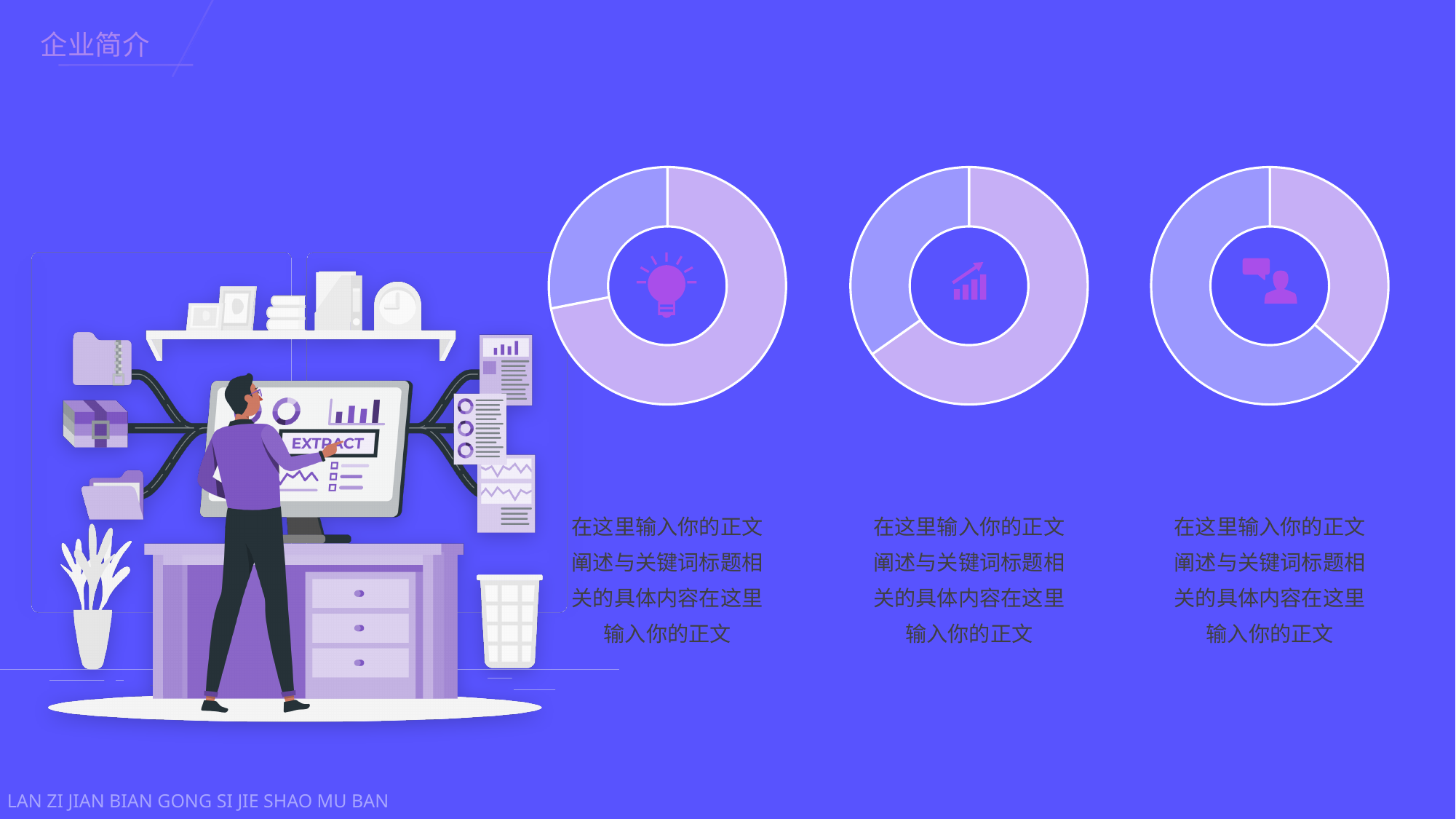
In the right donut chart (with the chat/person icon), is the light lavender slice greater or less than half of the ring? less In the middle donut chart (with the bar-graph icon), which slice is larger, the light lavender one or the blue one? The light lavender one What kind of chart is shown on the right side of the slide? Donut (pie) chart In the left donut chart (with the light bulb icon), which slice is larger, the light lavender one or the blue one? The light lavender one How many donut charts are on the slide? 3 Do the donut charts display any data labels or a legend? No What icon appears in the centre of the left donut chart? A light bulb In the left donut chart (with the light bulb icon), is the light lavender slice greater or less than half of the ring? greater